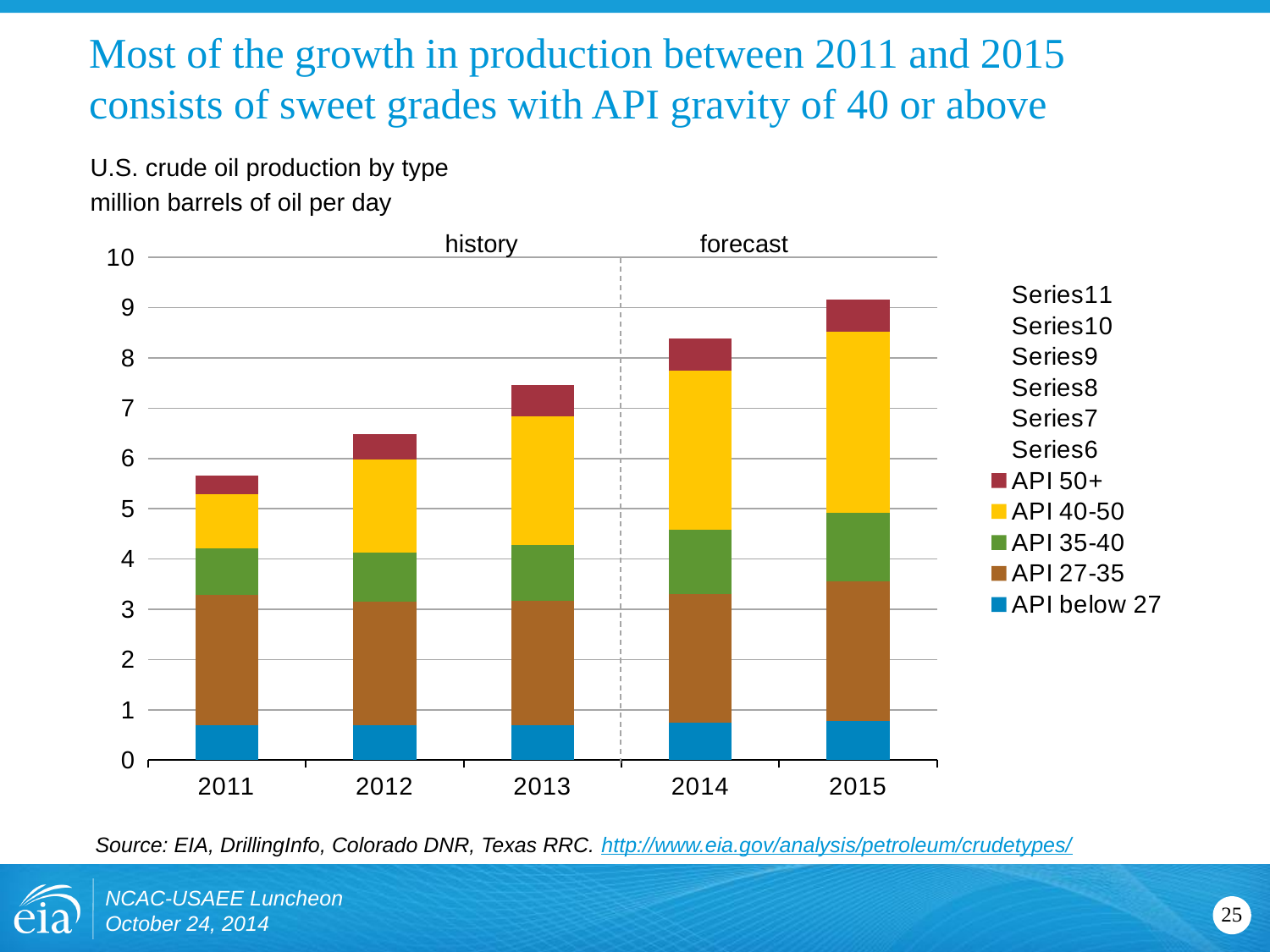
Do total crude oil production values rise or fall from 2011 to 2015? Rise Which years in the chart fall in the forecast period? 2014 and 2015 Is the total production for 2011 greater or less than 6 million barrels per day? less How many years are shown on the x axis of the chart? 5 How many entries does the chart's legend list? 11 Which year has the lowest total crude oil production in the chart? 2011 Which year has the larger API 40-50 segment, 2011 or 2015? 2015 Which year has the highest total crude oil production in the chart? 2015 Is the API below 27 segment for 2011 greater or less than 1 million barrels per day? less Is the total production for 2015 greater or less than 9 million barrels per day? greater What unit is the chart's y axis measured in, according to the subtitle? million barrels of oil per day What kind of chart is shown on the slide? Stacked bar chart